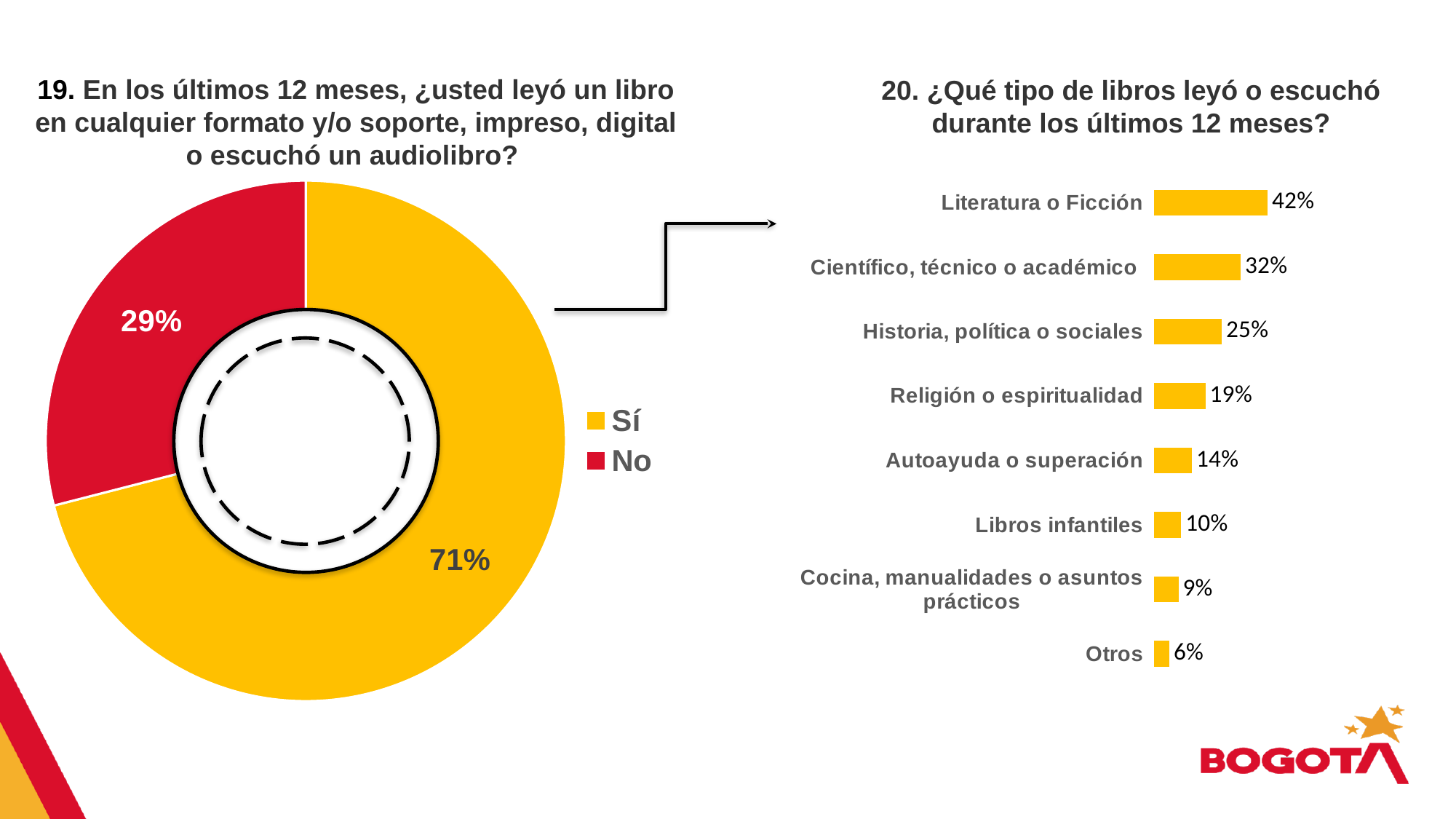
In the right chart (question 20), how many categories are shown? 8 What kind of chart is the left chart (question 19)? Pie chart (doughnut) What kind of chart is the right chart (question 20)? Bar chart In the left chart (question 19), what percentage answered "Sí"? 71% In the left chart (question 19), what is the difference between the "Sí" and "No" shares? 42% How many entries does the legend of the left chart (question 19) list? 2 In the left chart (question 19), what percentage answered "No"? 29% In the right chart (question 20), which category has the highest value? Literatura o Ficción In the right chart (question 20), what is the value for "Literatura o Ficción"? 42% In the right chart (question 20), what is the value for "Religión o espiritualidad"? 19% In the right chart (question 20), what is the difference between "Científico, técnico o académico" and "Historia, política o sociales"? 7% In the right chart (question 20), which category has the lowest value? Otros